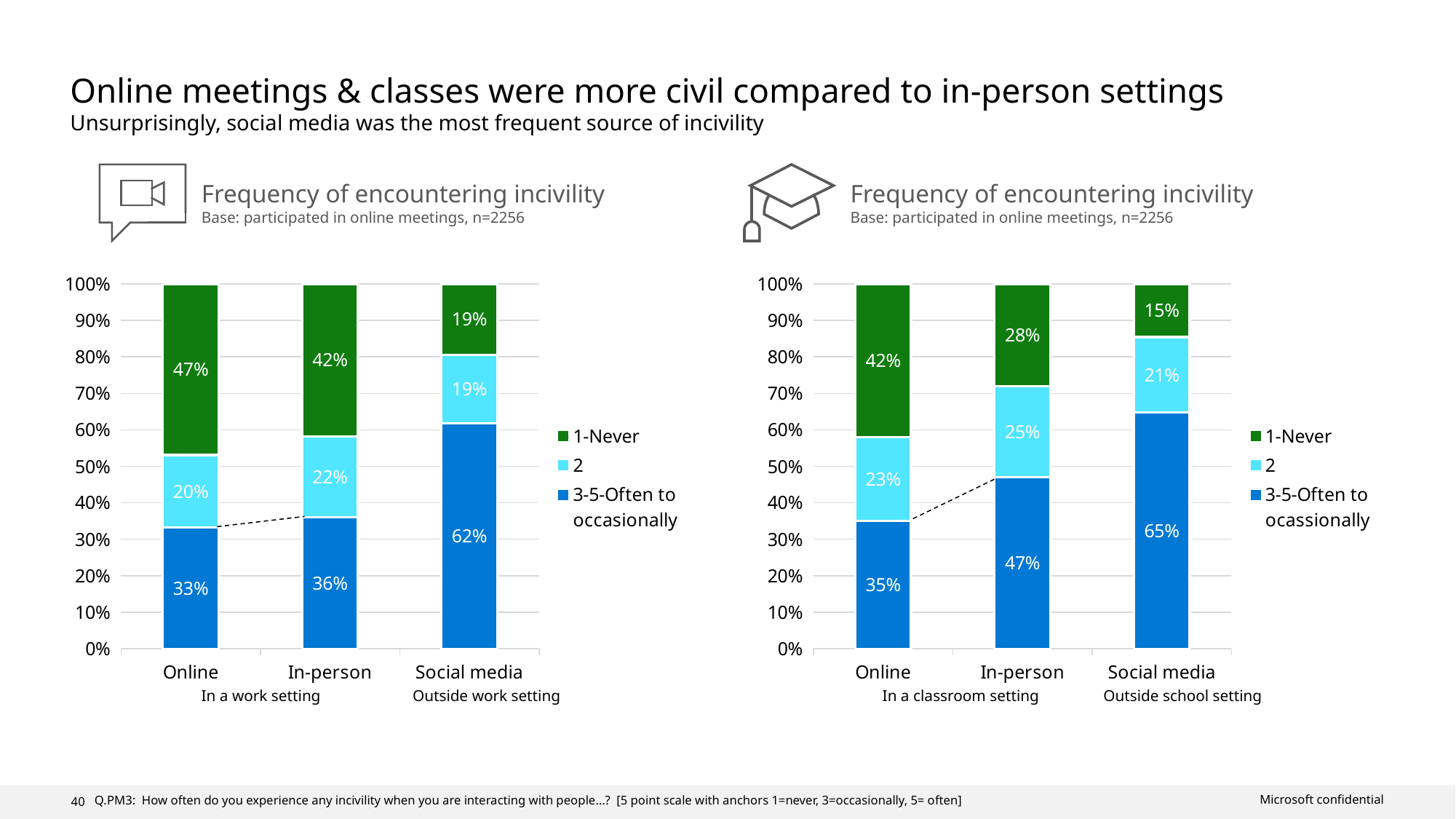
In the left chart (work setting), what is the value of the '3-5-Often to occasionally' segment for Social media? 62% In the left chart (work setting), which category has the lowest '1-Never' value? Social media In the right chart (classroom setting), what is the combined value of the '2' and '1-Never' segments for Social media? 36% In the left chart (work setting), what is the value of the '2' segment for In-person? 22% In the left chart (work setting), which is larger: the '1-Never' value for Online or for In-person? Online In the right chart (classroom setting), which category has the highest '3-5-Often to occasionally' value? Social media How many categories are shown on the x axis of the left chart (work setting)? 3 In the right chart (classroom setting), what is the value of the '1-Never' segment for In-person? 28% In the right chart (classroom setting), what is the difference between the '3-5-Often to occasionally' values for In-person and Online? 12% How many series does the legend of the right chart (classroom setting) list? 3 In the right chart (classroom setting), is the '3-5-Often to occasionally' value for Social media greater or less than 60%? greater What type of chart is the left chart (work setting)? Stacked bar chart